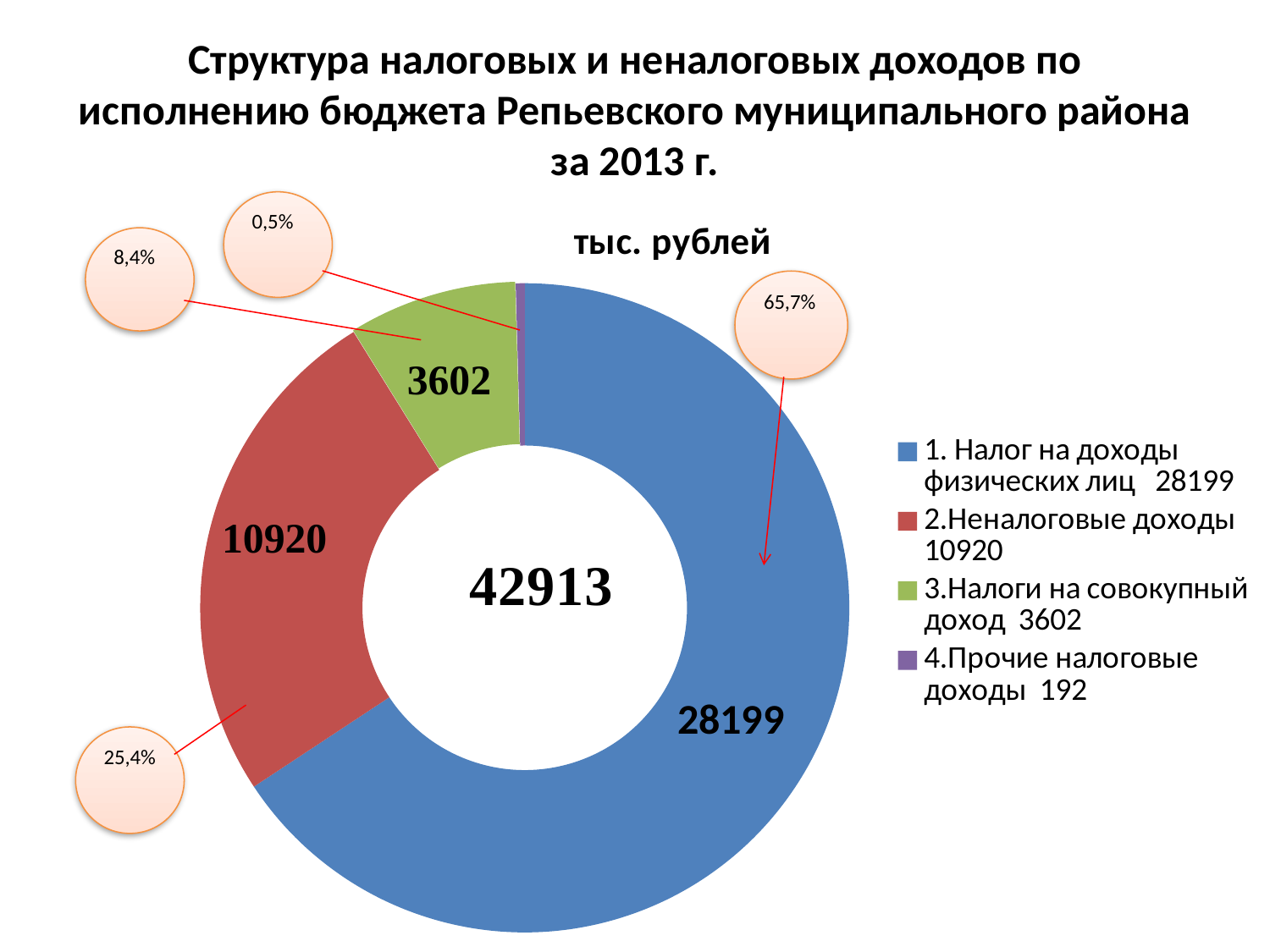
What share of the total does "3.Налоги на совокупный доход" represent, as labelled on the slide? 8,4% How many categories does the legend list? 4 What share of the total does "1. Налог на доходы физических лиц" represent, as labelled on the slide? 65,7% What is the value for "1. Налог на доходы физических лиц"? 28199 What type of chart is shown on the slide? doughnut (pie) chart What is the value for "2.Неналоговые доходы"? 10920 Which category has the smallest value? 4.Прочие налоговые доходы Which is larger: "2.Неналоговые доходы" or "3.Налоги на совокупный доход"? 2.Неналоговые доходы What is the value for "4.Прочие налоговые доходы"? 192 Which category has the largest value? 1. Налог на доходы физических лиц What is the value for "3.Налоги на совокупный доход"? 3602 What is the difference between the values for "1. Налог на доходы физических лиц" and "2.Неналоговые доходы"? 17279